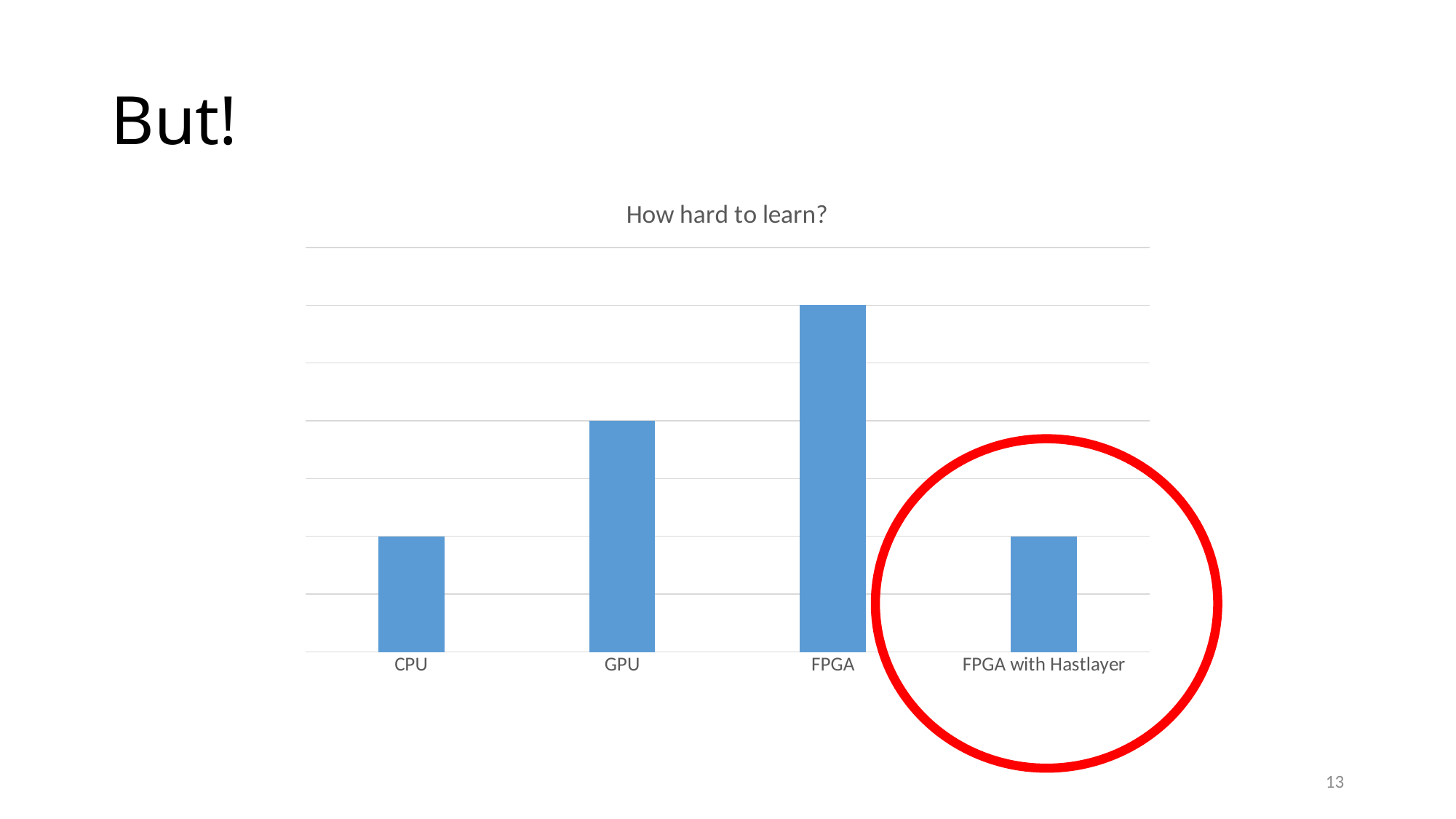
Which bar is taller, GPU or FPGA? FPGA How many categories are plotted in the chart? 4 What is the title of the chart? How hard to learn? What is the label of the third category from the left? FPGA Which bar is taller, FPGA or FPGA with Hastlayer? FPGA Which bar is shorter, GPU or FPGA with Hastlayer? FPGA with Hastlayer What kind of chart is shown on the slide? bar chart Which category is circled in red on the slide? FPGA with Hastlayer Which category has the highest bar in the chart? FPGA